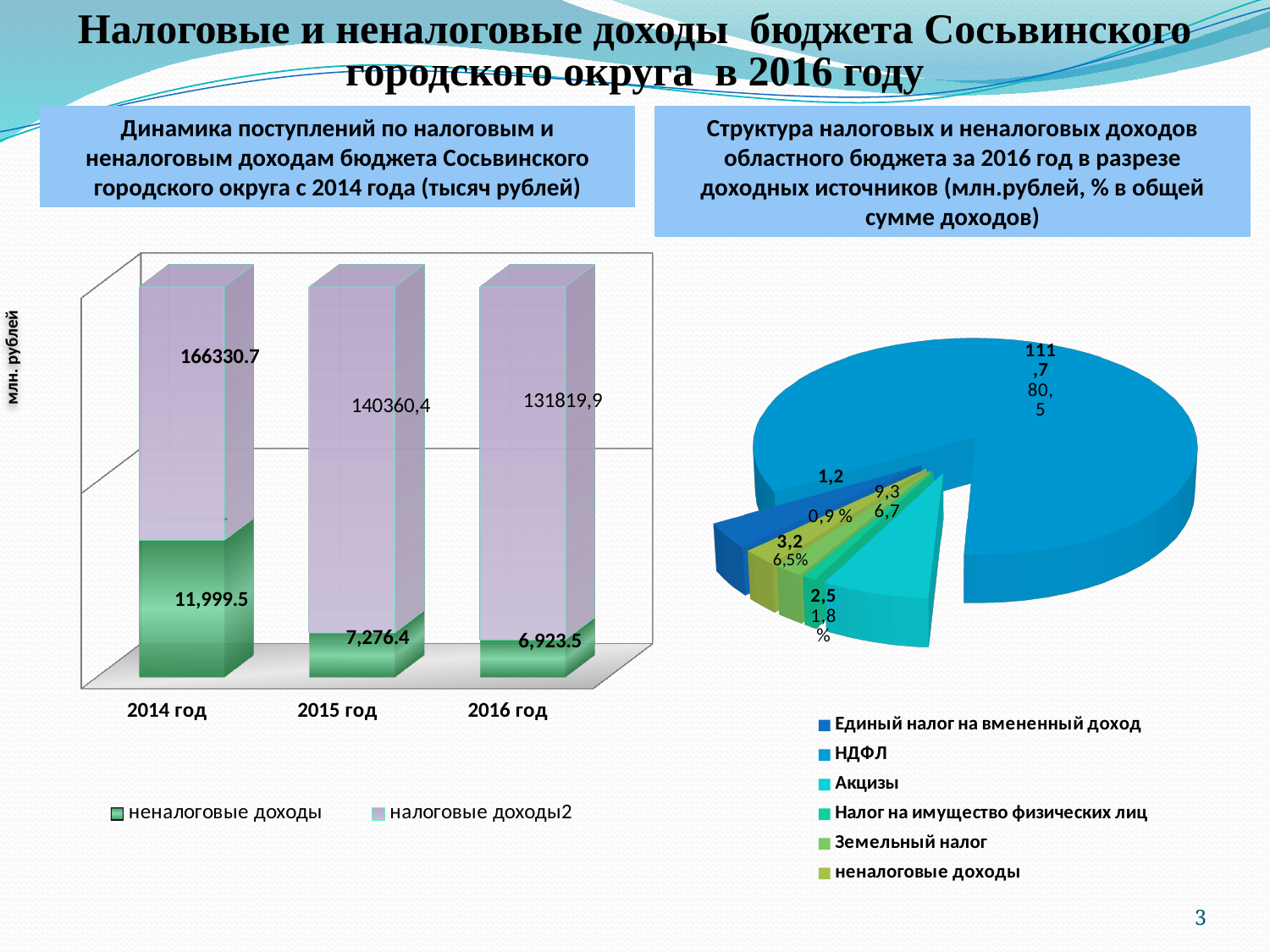
In the left bar chart, what is the value of 'неналоговые доходы' for 2016 год? 6,923.5 In the left bar chart, what is the value of 'налоговые доходы2' for 2014 год? 166330.7 In the left bar chart, what is the difference between 'налоговые доходы2' in 2015 год (140360,4) and in 2016 год (131819,9)? 8540,5 In the right pie chart, how many entries does the legend list? 6 What kind of chart is the left chart, 'Динамика поступлений по налоговым и неналоговым доходам'? bar chart What kind of chart is the right chart, 'Структура налоговых и неналоговых доходов'? pie chart In the left bar chart, how many series does the legend list? 2 In the left bar chart, which is larger: 'неналоговые доходы' in 2015 год or in 2016 год? 2015 год In the left bar chart, do the values for 'налоговые доходы2' rise or fall from 2014 год to 2016 год? fall In the right pie chart, what value in млн.рублей is labelled on the largest slice (НДФЛ)? 111,7 In the left bar chart, how many years are shown on the x axis? 3 In the left bar chart, which year has the highest value for 'неналоговые доходы'? 2014 год